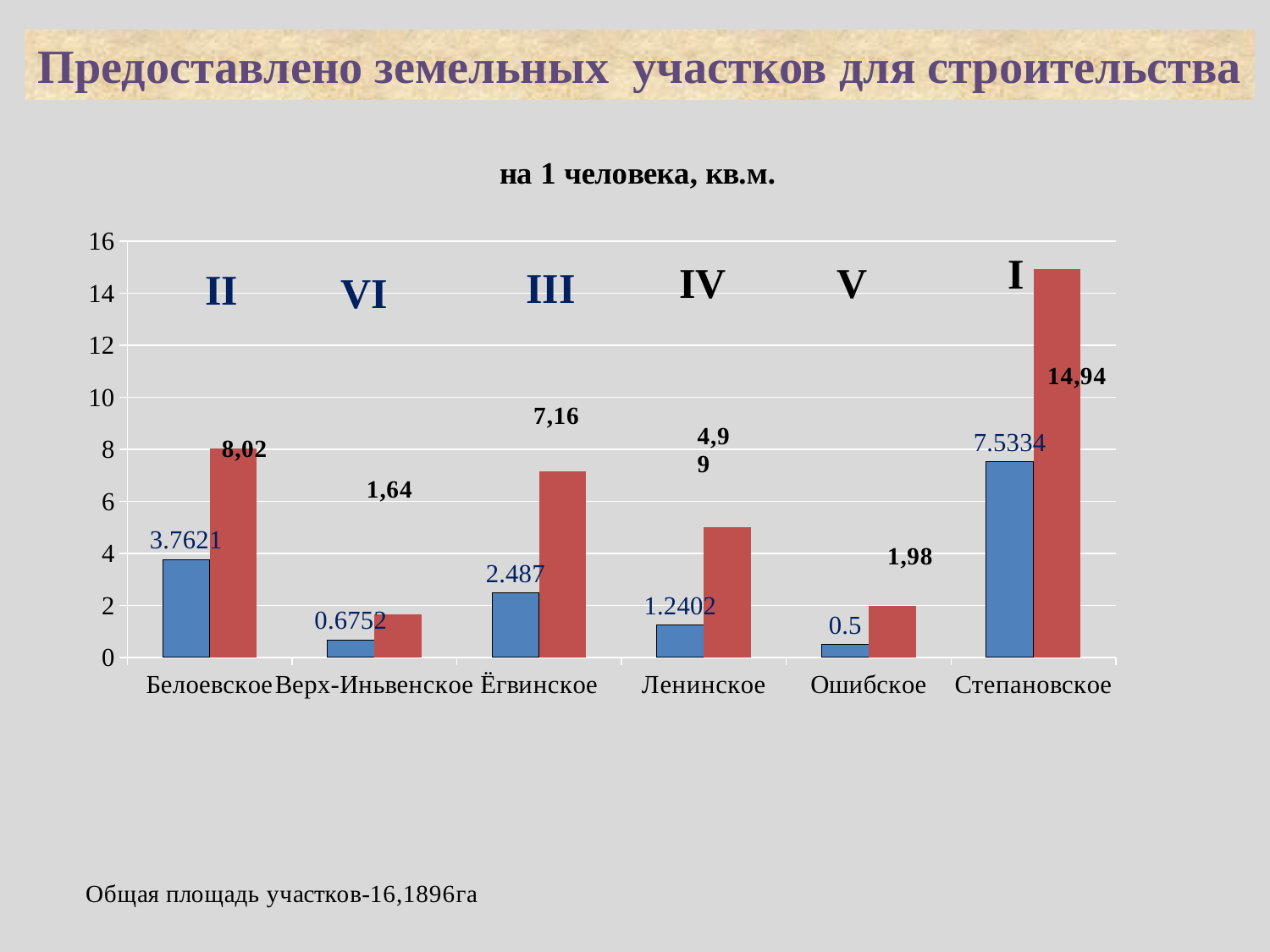
Is the value of the red bar for Ленинское greater or less than 4? greater Which category has the lowest blue bar? Ошибское What is the value of the red bar for Ошибское? 1,98 Which red bar is larger: Белоевское or Ёгвинское? Белоевское What is the title of the chart? на 1 человека, кв.м. What is the difference between the red bar values for Степановское and Белоевское? 6,92 How many categories are shown on the x axis? 6 Which category has the highest red bar? Степановское What is the value of the blue bar for Белоевское? 3.7621 What is the value of the red bar for Степановское? 14,94 What is the value of the blue bar for Ошибское? 0.5 What kind of chart is shown on the slide? bar chart